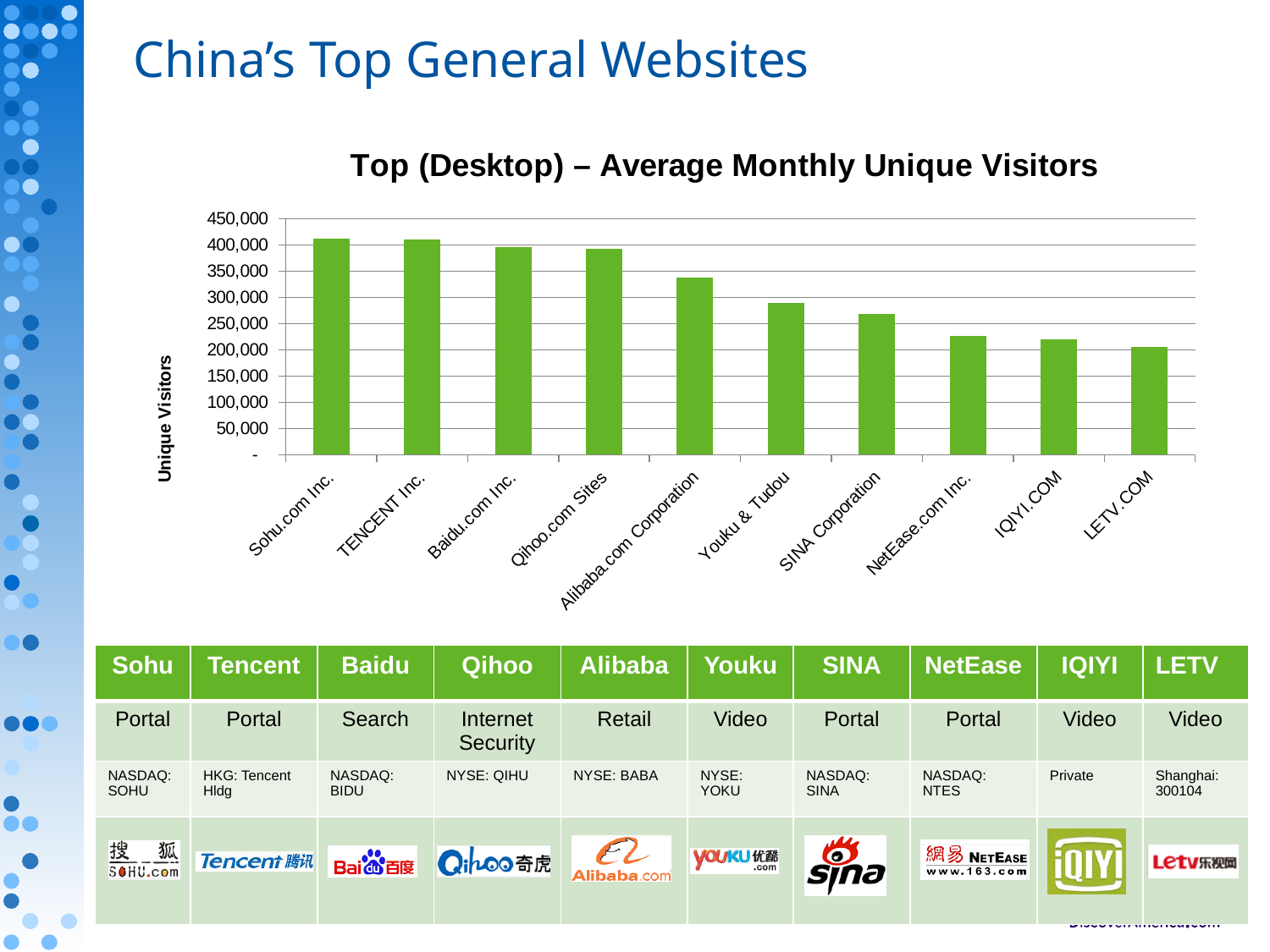
Is the value for Alibaba.com Corporation greater or less than 350,000? less Which has more unique visitors, Youku & Tudou or LETV.COM? Youku & Tudou Which has more unique visitors, Baidu.com Inc. or SINA Corporation? Baidu.com Inc. Is the value for Alibaba.com Corporation greater or less than 300,000? greater Is the value for Youku & Tudou greater or less than 250,000? greater What is the title of the chart? Top (Desktop) – Average Monthly Unique Visitors What kind of chart is shown on the slide? bar chart Do the values rise or fall moving from left to right along the x axis? fall How many websites (categories) are plotted in the chart? 10 What is the label on the vertical axis of the chart? Unique Visitors